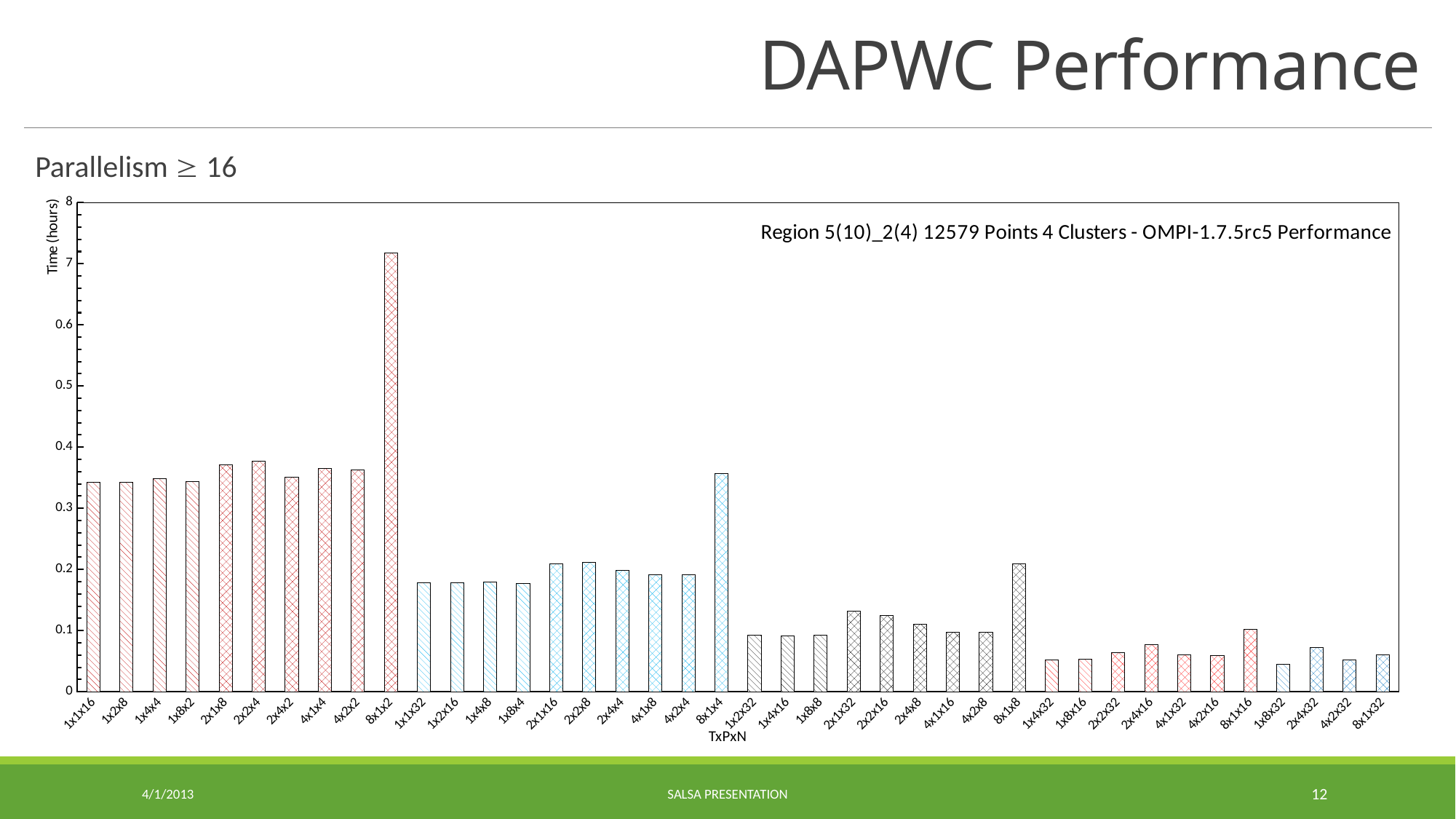
What is the label of the y axis? Time (hours) Is the value for 1x1x16 greater or less than 0.3? greater Which has the larger time, 2x2x4 or 1x1x32? 2x2x4 Is the value for 8x1x4 greater or less than 0.3? greater Is the value for 1x8x32 greater or less than 0.1? less Which has the larger time, 8x1x2 or 8x1x4? 8x1x2 How many TxPxN categories are plotted on the x axis? 40 Do the times generally rise or fall moving from left to right along the x axis? fall What kind of chart is shown on the slide? bar chart Which TxPxN configuration has the highest time? 8x1x2